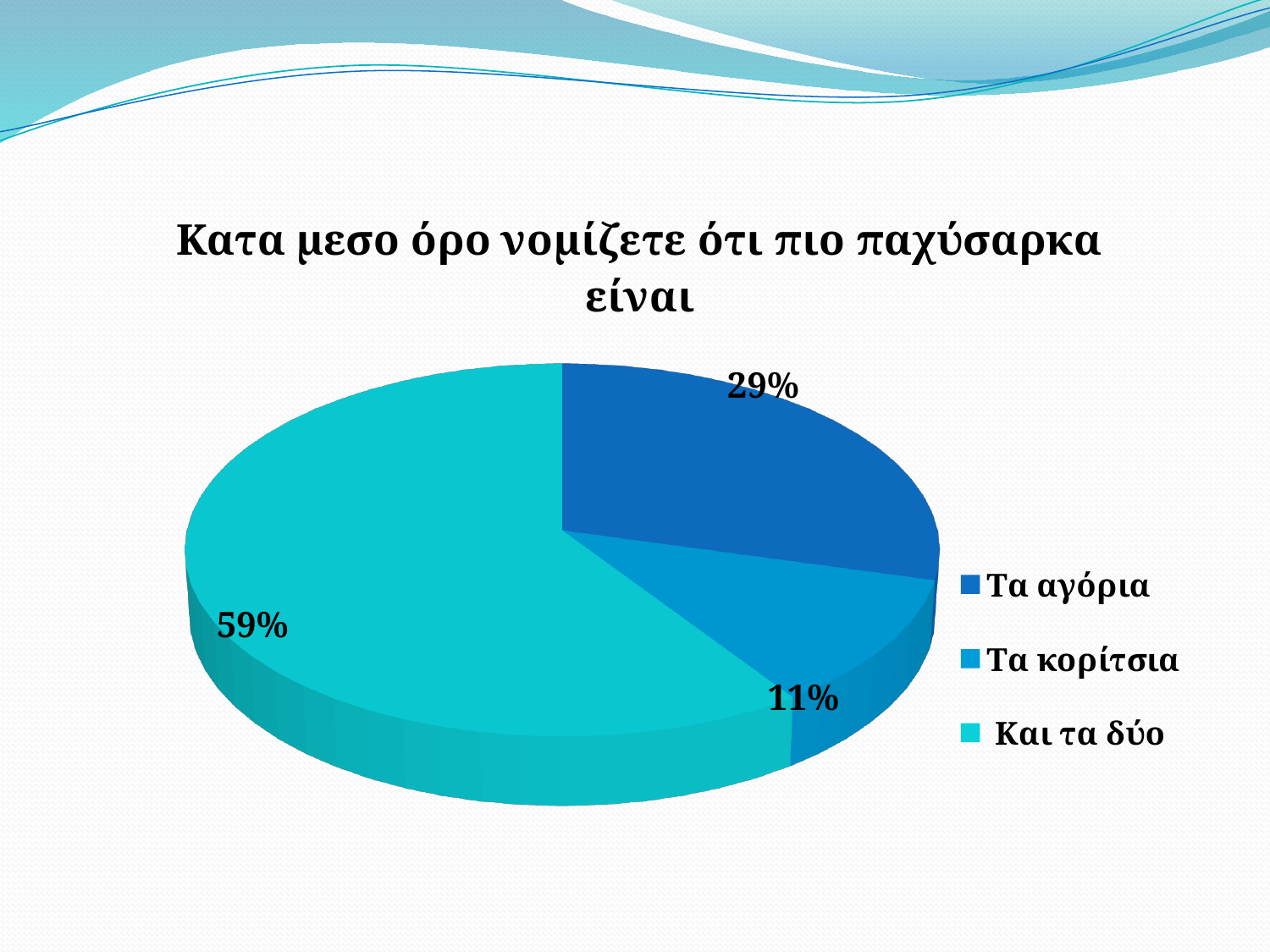
Which legend entry is shown in the darkest blue colour? Τα αγόρια What percentage of the pie is labelled "Τα κορίτσια"? 11% What is the difference in percentage points between "Και τα δύο" and "Τα αγόρια"? 30 What kind of chart is shown on the slide? Pie chart Which category has the largest share of the pie? Και τα δύο What percentage of the pie is labelled "Τα αγόρια"? 29% Which category has the smallest share of the pie? Τα κορίτσια What percentage of the pie is labelled "Και τα δύο"? 59% Which is larger, the share for "Τα αγόρια" or the share for "Τα κορίτσια"? Τα αγόρια What is the difference in percentage points between "Τα αγόρια" and "Τα κορίτσια"? 18 What is the title of the chart? Κατα μεσο όρο νομίζετε ότι πιο παχύσαρκα είναι How many slices does the pie chart have? 3